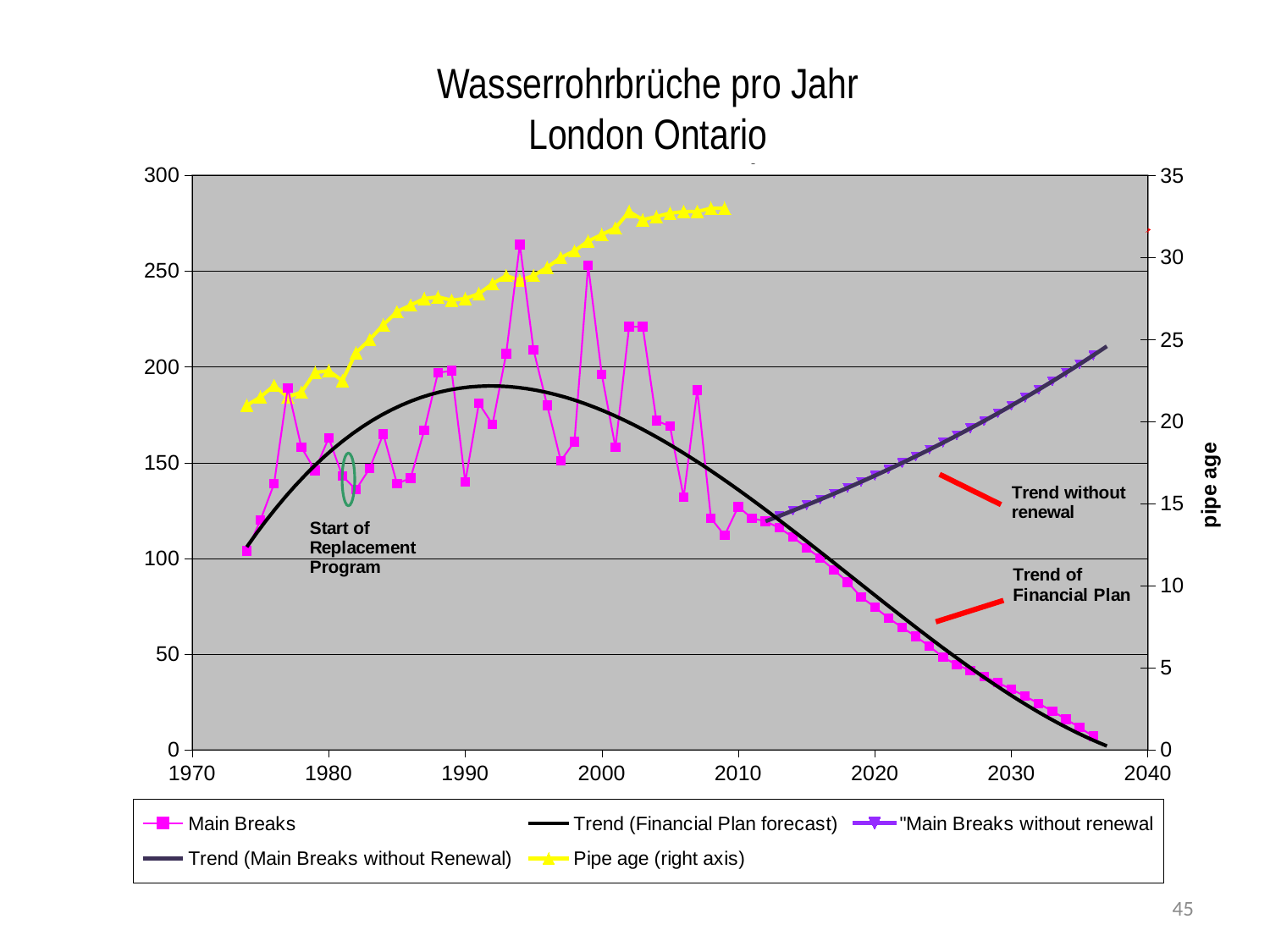
How many series does the legend list? 5 Does the Pipe age series rise or fall from 1974 to 2009? rise What is the title of the chart? Wasserrohrbrüche pro Jahr London Ontario What kind of chart is shown on the slide? line chart In which year does the Main Breaks series reach its highest value? 1994 Is the Pipe age value in 2009 greater or less than 30 on the right axis? greater Is the value of the Trend (Financial Plan forecast) line in 2037 greater or less than 50? less What is the label of the right-hand vertical axis? pipe age Is the value for Main Breaks in 1994 greater or less than 250? greater